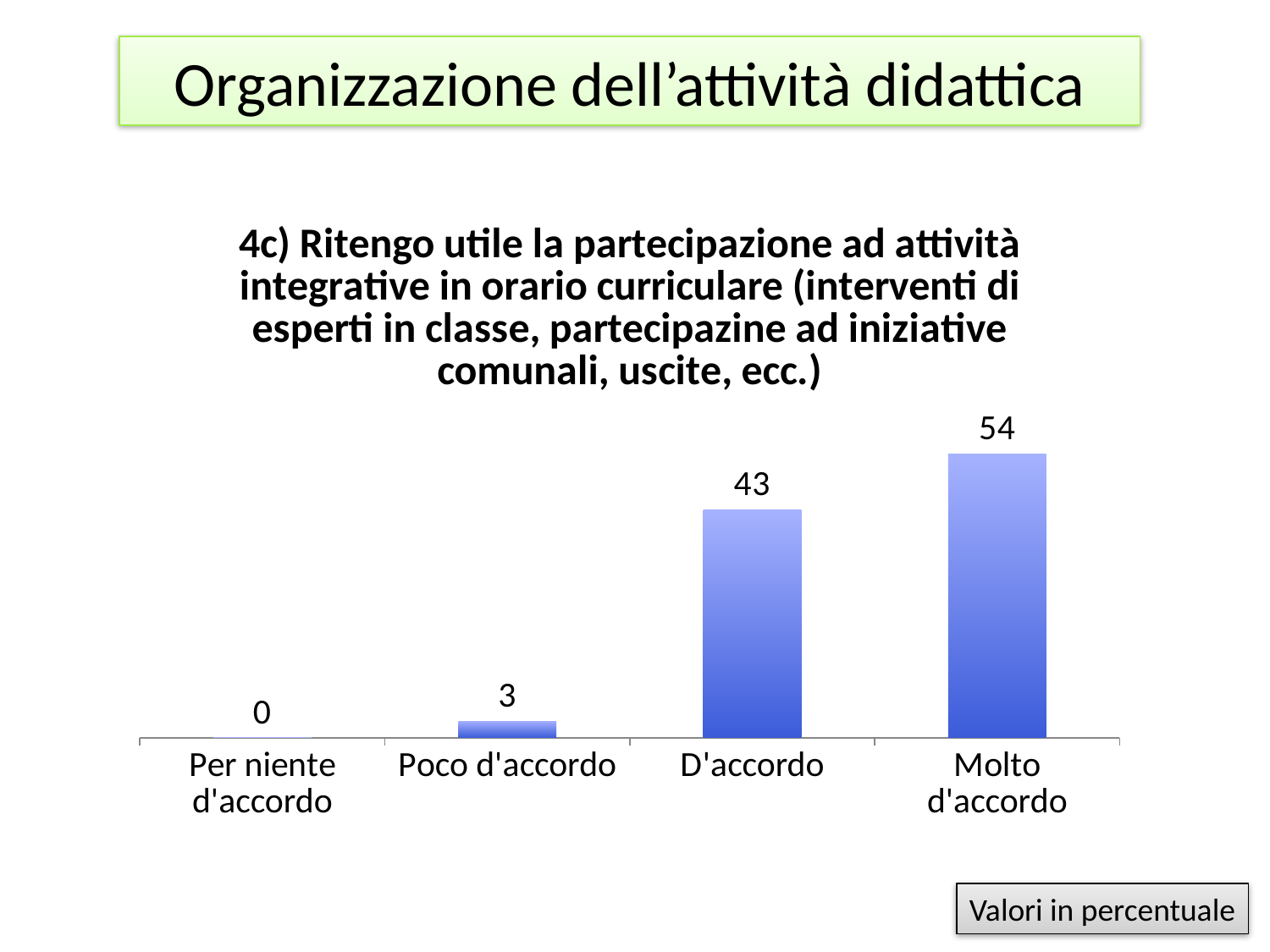
What is the value for "D'accordo"? 43 How many categories are shown on the x axis? 4 What is the value for "Per niente d'accordo"? 0 Which is larger, the value for "D'accordo" or the value for "Poco d'accordo"? D'accordo What is the difference between the values for "D'accordo" and "Poco d'accordo"? 40 Which category has the lowest value? Per niente d'accordo Which category has the highest value? Molto d'accordo What is the difference between the values for "Molto d'accordo" and "D'accordo"? 11 Do the values rise or fall from left to right along the x axis? Rise What kind of chart is shown on the slide? Bar chart What is the value for "Molto d'accordo"? 54 What is the value for "Poco d'accordo"? 3